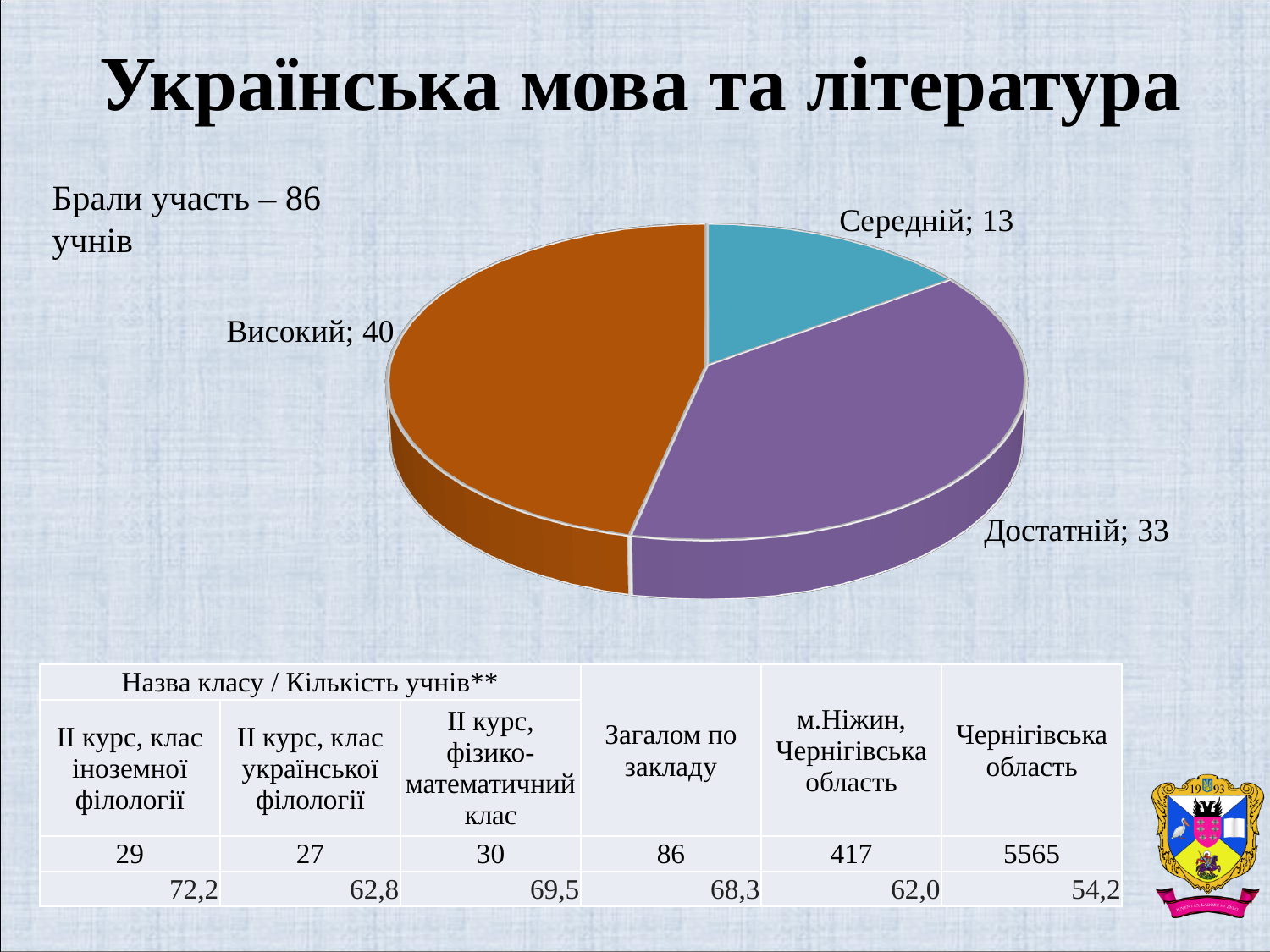
What is the difference between the values for Достатній and Середній? 20 What is the difference between the values for Високий and Достатній? 7 Which is larger, the value for Достатній or the value for Середній? Достатній How many slices does the pie chart have? 3 What is the total of all slices in the pie chart? 86 Which category has the largest slice in the pie chart? Високий What is the value for Високий in the pie chart? 40 What is the value for Середній in the pie chart? 13 Which category has the smallest slice in the pie chart? Середній What is the title of the slide containing the pie chart? Українська мова та література What is the value for Достатній in the pie chart? 33 What kind of chart is shown on the slide? pie chart